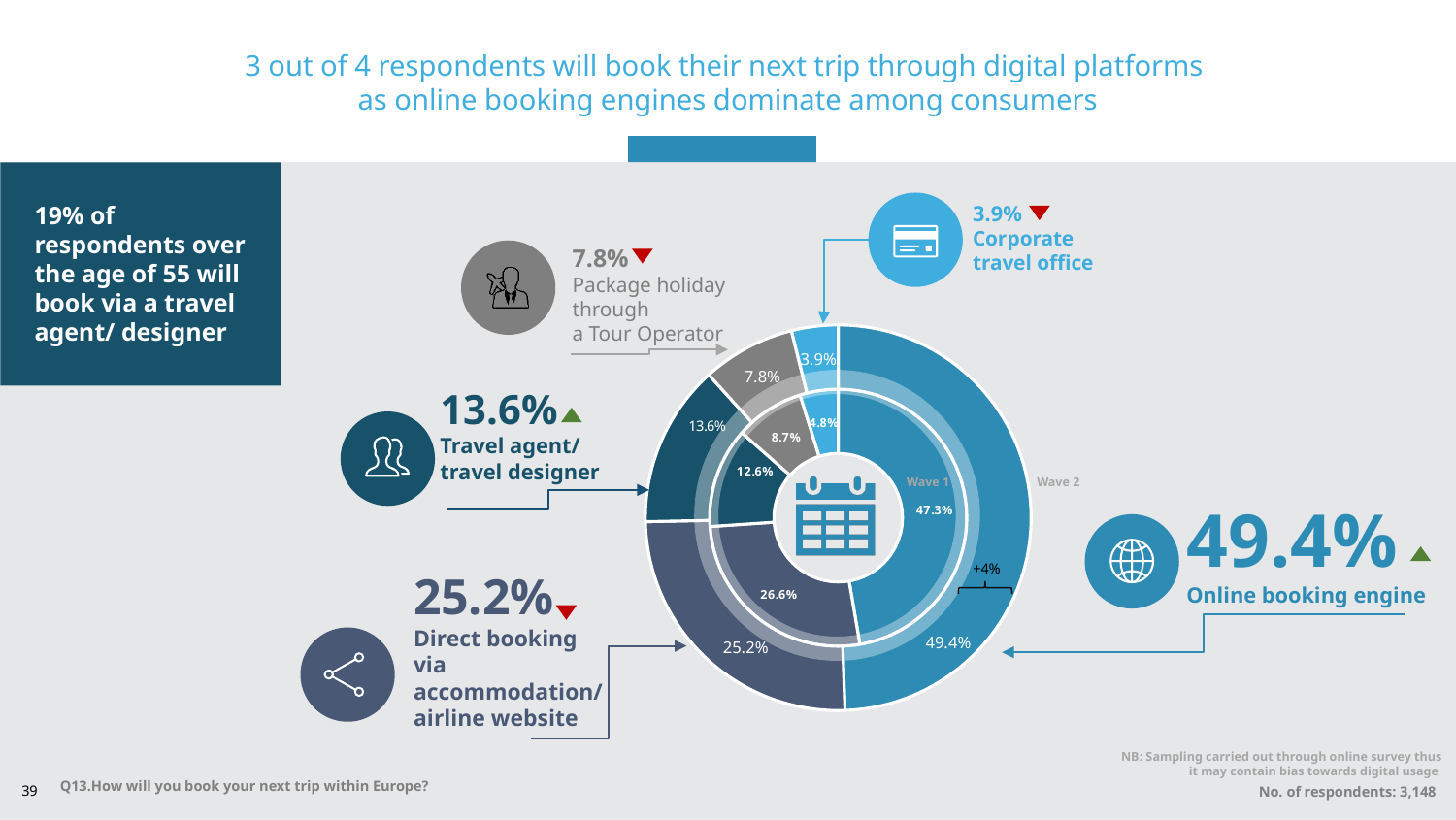
How many booking methods are shown in the chart? 5 In Wave 2, which is larger: travel agent/travel designer or package holiday through a tour operator? Travel agent/travel designer What share of respondents will book their next trip through an online booking engine in Wave 2? 49.4% What was the Wave 1 share for online booking engine? 47.3% What was the Wave 1 share for travel agent/travel designer? 12.6% Which booking method has the largest share in Wave 2? Online booking engine What is the Wave 2 value for direct booking via accommodation/airline website? 25.2% Which booking method has the smallest share in Wave 2? Corporate travel office In Wave 2, how many percentage points higher is online booking engine than direct booking via accommodation/airline website? 24.2 percentage points What was the Wave 1 share for package holiday through a tour operator? 8.7% How many waves (series) does the chart show? 2 What type of chart is used on this slide? Doughnut chart